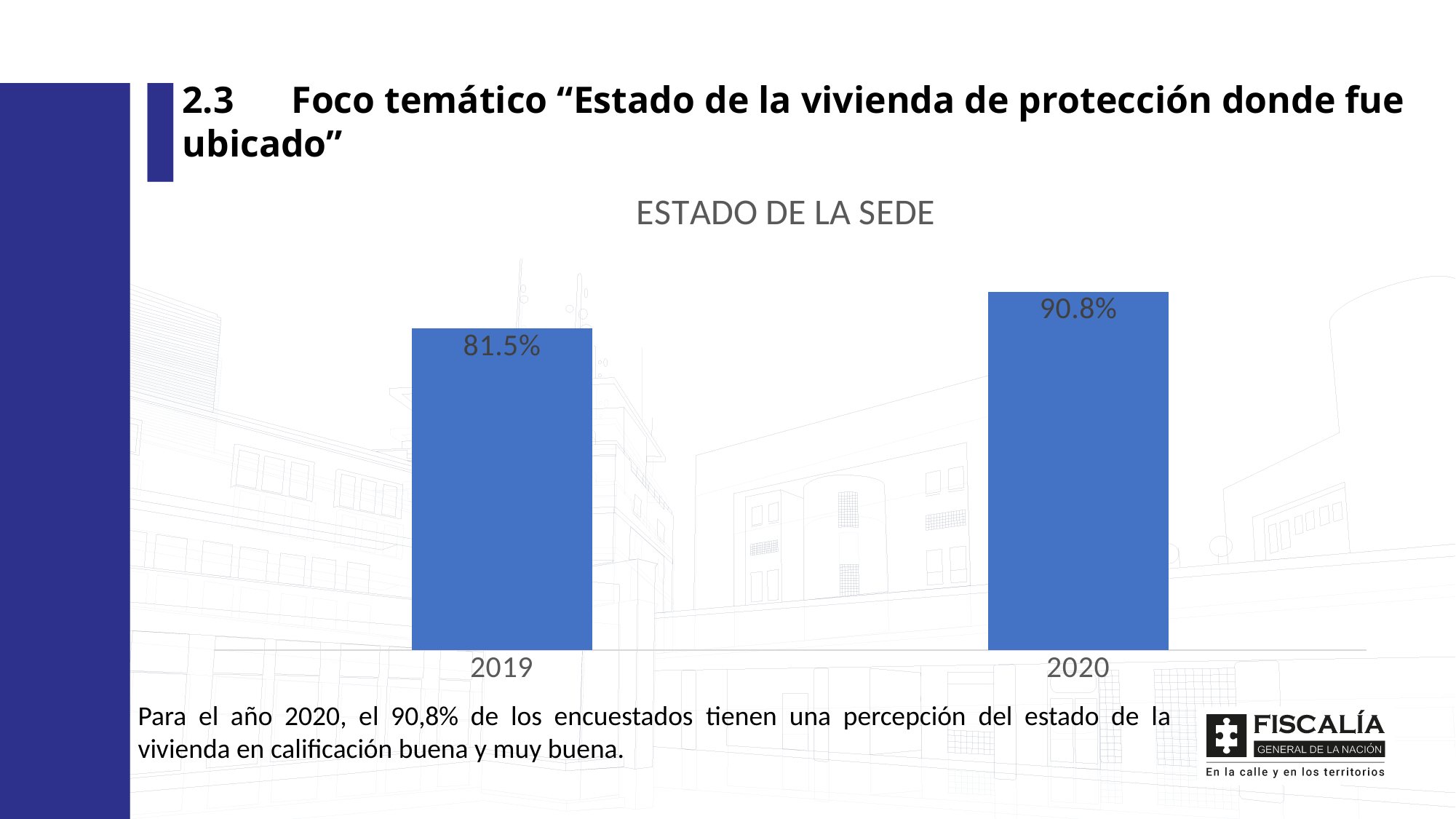
What is the difference between the values for 2020 and 2019? 9.3% Do the values rise or fall from 2019 to 2020? rise What is the title of the chart? ESTADO DE LA SEDE What is the value for 2019? 81.5% What colour are the bars in the chart? blue Which year has the lowest value? 2019 Which year has the highest value? 2020 Which is larger, the value for 2019 or the value for 2020? 2020 What kind of chart is shown on the slide? bar chart How many categories are shown in the chart? 2 What is the value for 2020? 90.8%